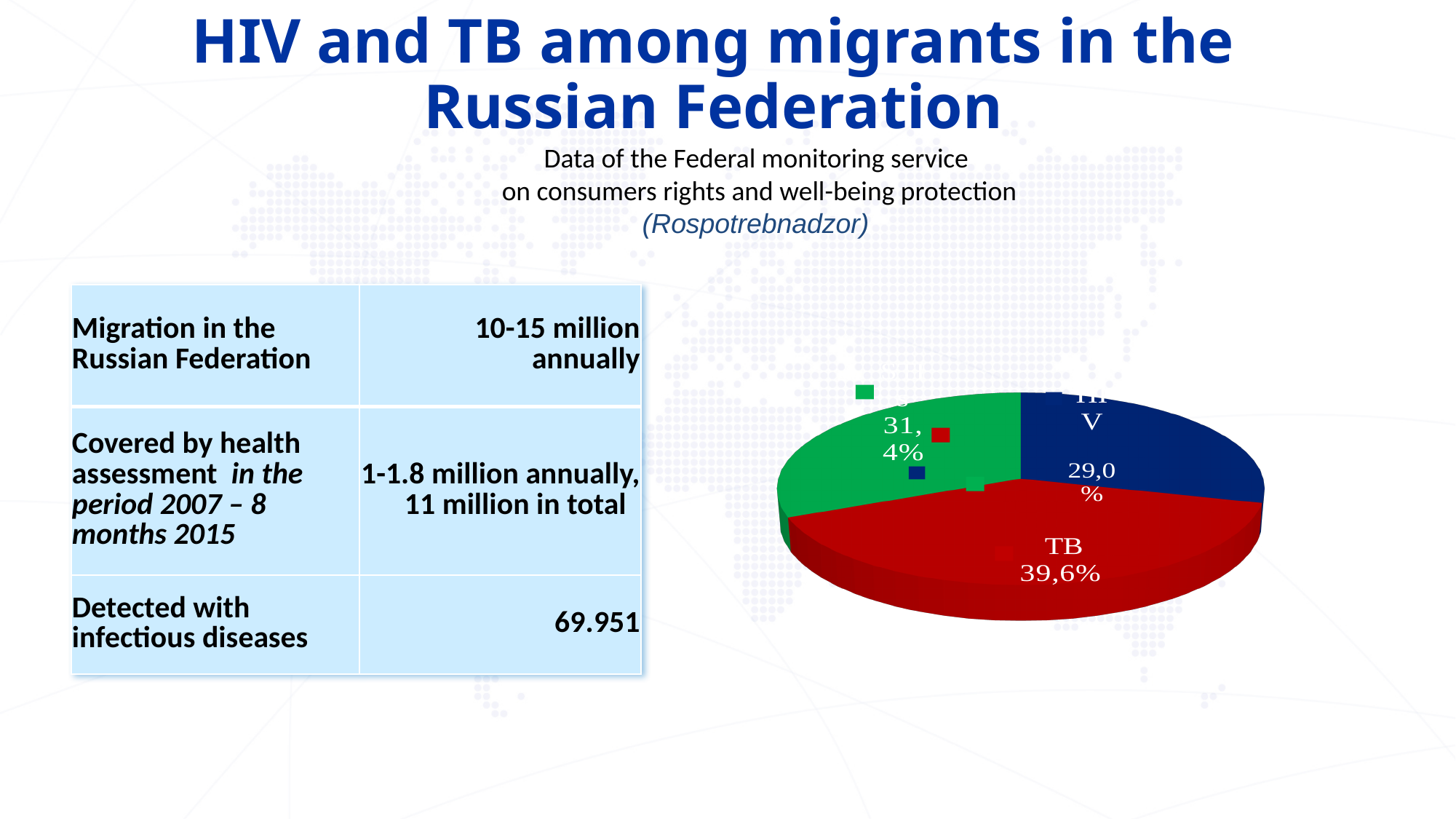
Which slice of the pie chart is the largest? TB Which labelled slice of the pie chart is the smallest? HIV What kind of chart is shown on the slide? pie chart What percentage is shown on the green slice of the pie chart? 31,4% What share of the pie chart does TB account for? 39,6% What colour is the TB slice in the pie chart? red By how many percentage points does the TB share exceed the HIV share in the pie chart? 10,6 How many slices does the pie chart have? 3 Which is larger in the pie chart, the TB share or the HIV share? TB What share of the pie chart does HIV account for? 29,0% What colour is the HIV slice in the pie chart? dark blue